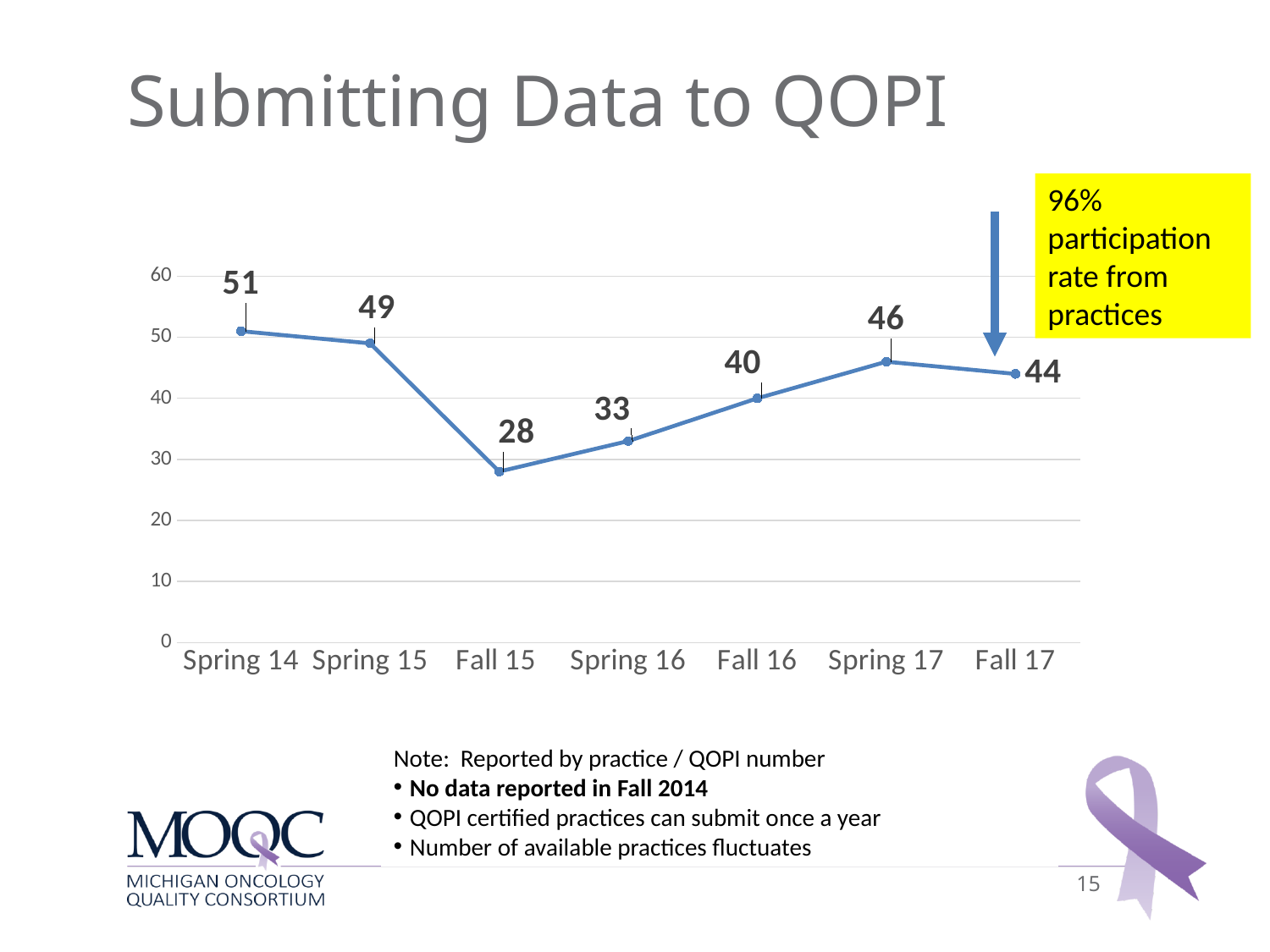
What kind of chart is shown on the slide? line chart What is the value for Spring 14? 51 What is the value for Fall 17? 44 How many periods are plotted on the x axis? 7 Is the value for Fall 16 greater or less than 30? greater Which period has the lowest value? Fall 15 Do the values rise or fall from Fall 15 to Spring 17? rise What is the difference between the values for Spring 14 and Fall 15? 23 What is the value for Fall 15? 28 Which period has the highest value? Spring 14 Which is larger, the value for Spring 16 or the value for Fall 16? Fall 16 What is the difference between the values for Spring 17 and Fall 17? 2